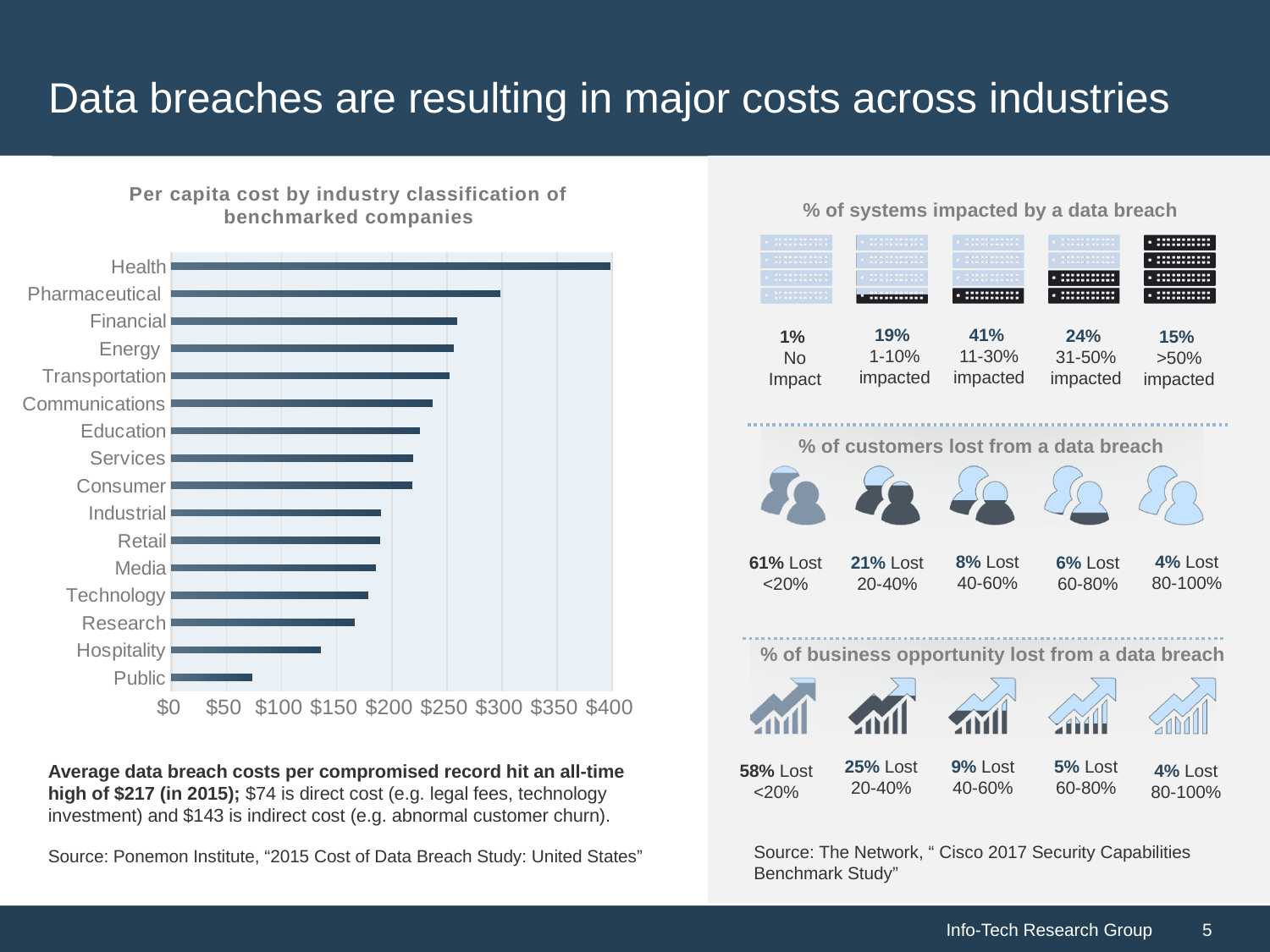
Is the per capita cost for Pharmaceutical greater or less than $250? greater What is the title of the bar chart on the left? Per capita cost by industry classification of benchmarked companies Which industry has the highest per capita cost in the bar chart? Health Which has a higher per capita cost, Research or Hospitality? Research Going down the bar chart from Health to Public, do the per capita costs rise or fall? fall Is the per capita cost for Public greater or less than $100? less How many industry categories are plotted in the bar chart? 16 What kind of chart is shown on the left of the slide? bar chart Is the per capita cost for Hospitality greater or less than $150? less Which industry has the lowest per capita cost in the bar chart? Public Which has a higher per capita cost, Pharmaceutical or Financial? Pharmaceutical